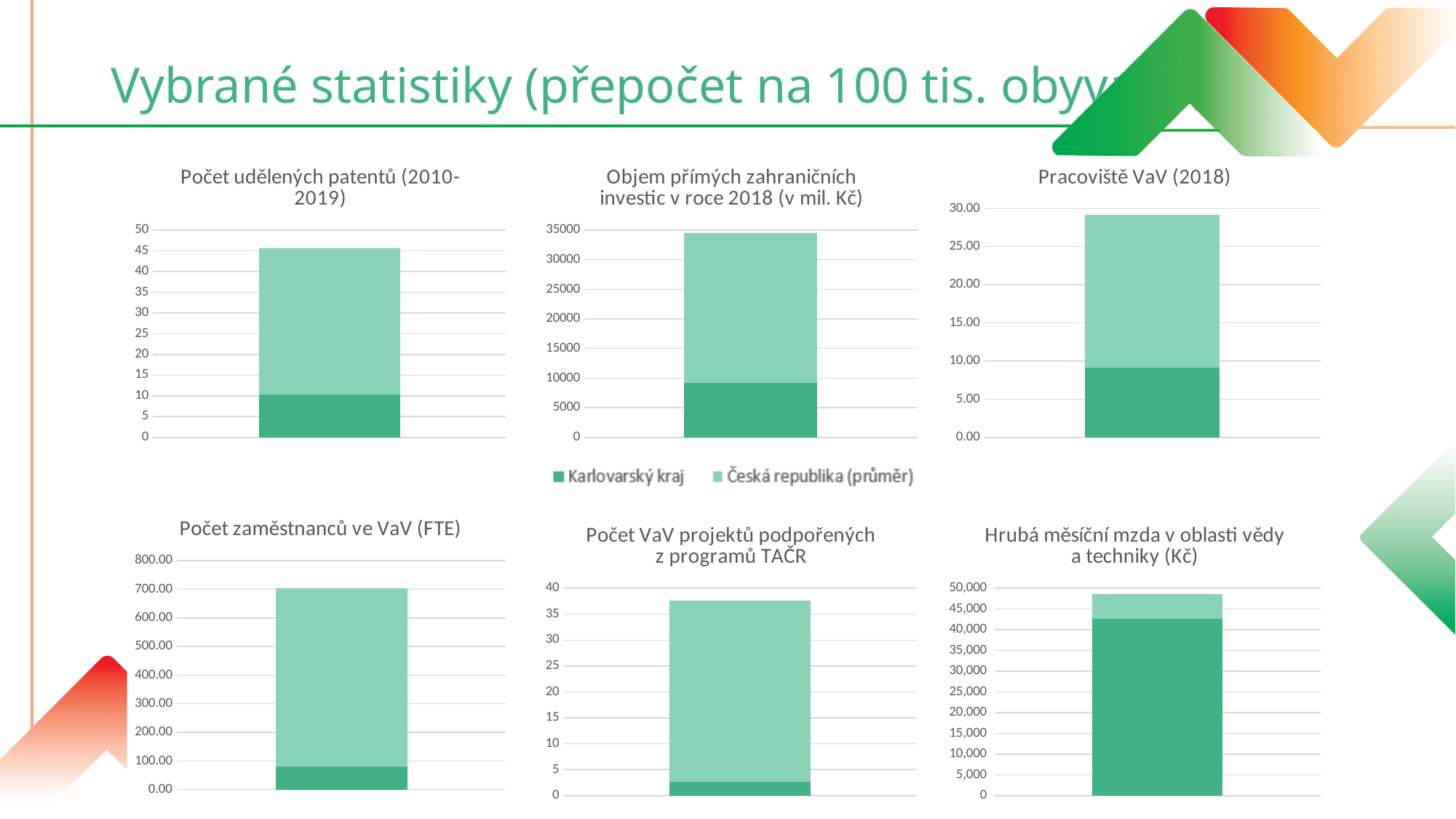
In the chart "Počet VaV projektů podpořených z programů TAČR", is the value for Karlovarský kraj greater or less than 5? less What kind of chart is "Počet udělených patentů (2010-2019)"? bar chart In the chart "Počet udělených patentů (2010-2019)", is the value for Česká republika (průměr) greater or less than 40? less How many charts are shown on the slide? 6 In the chart "Hrubá měsíční mzda v oblasti vědy a techniky (Kč)", which series has the larger value, Karlovarský kraj or Česká republika (průměr)? Karlovarský kraj In the chart "Objem přímých zahraničních investic v roce 2018 (v mil. Kč)", is the value for Česká republika (průměr) greater or less than 30000? less How many series does the legend on the slide list? 2